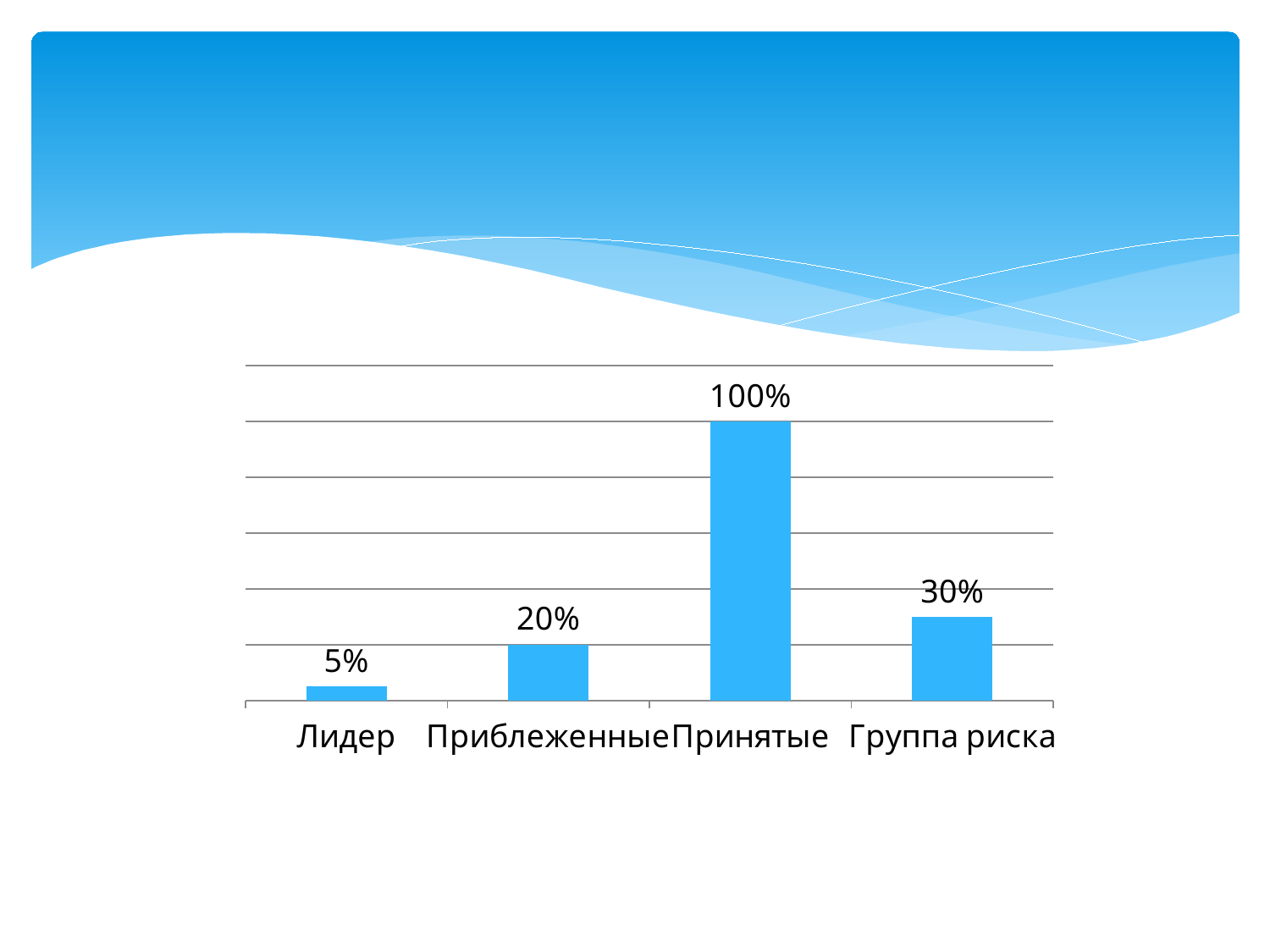
Which is larger, the value for Группа риска or the value for Приблеженные? Группа риска Which category has the lowest value? Лидер What is the difference between the values for Принятые and Группа риска? 70% Which category has the highest value? Принятые What is the value for Группа риска? 30% What is the value for Принятые? 100% What kind of chart is shown on the slide? Bar chart What is the value for Приблеженные? 20% What is the difference between the values for Приблеженные and Лидер? 15% What colour are the bars in the chart? Blue How many categories are shown on the x axis? 4 What is the value for Лидер? 5%